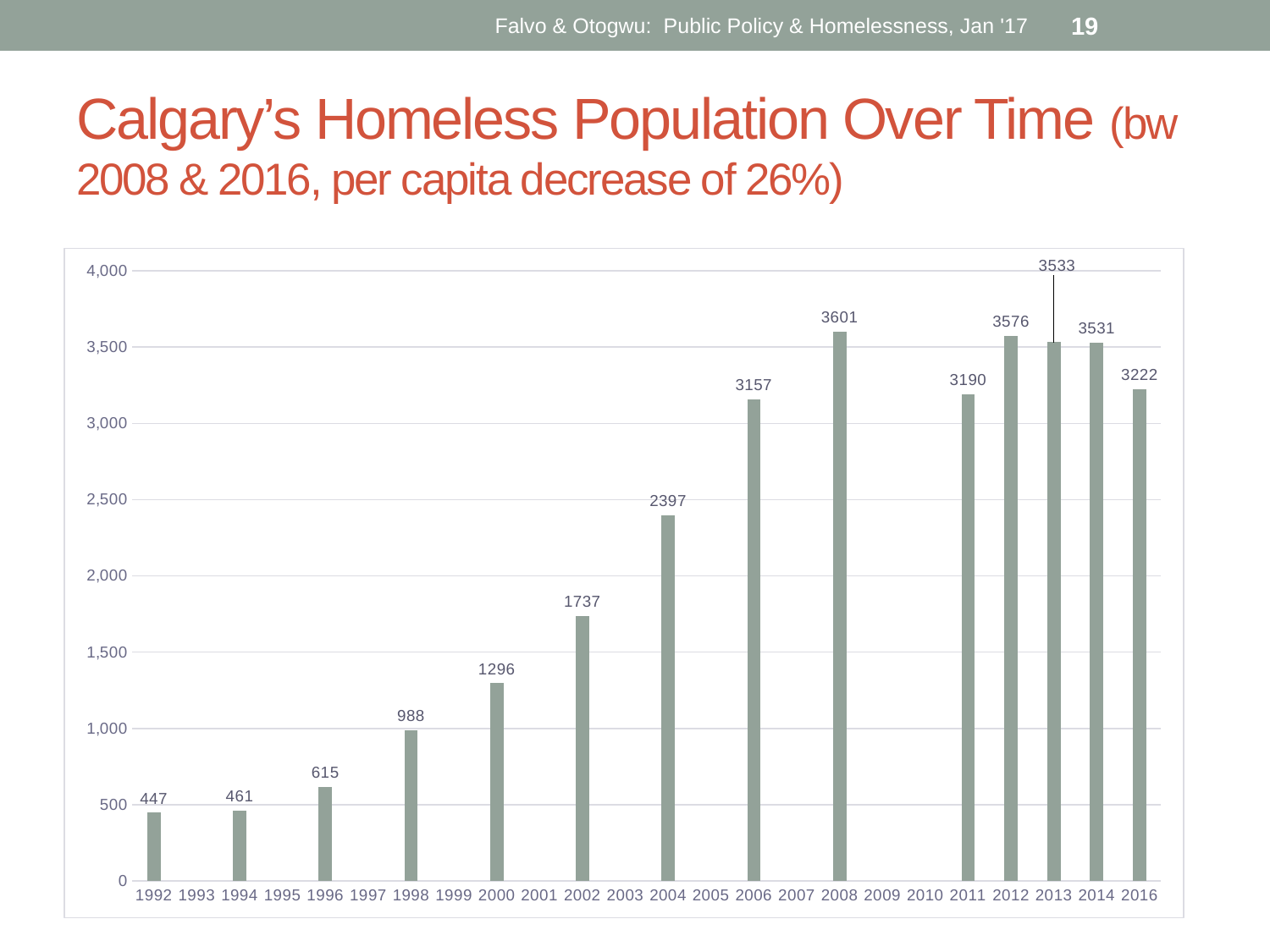
What kind of chart is shown on the slide? bar chart What is the value for 1998? 988 What is the difference between the values for 2008 and 2016? 379 What is the value for 2008? 3601 What is the value for 2016? 3222 Is the value for 2006 greater or less than 3,000? greater Which is larger, the value for 2012 or the value for 2013? 2012 What is the difference between the values for 1994 and 1992? 14 Do the values rise or fall from 1992 to 2008? rise How many bars are plotted on the chart? 14 Which year has the lowest value? 1992 Which year has the highest value? 2008